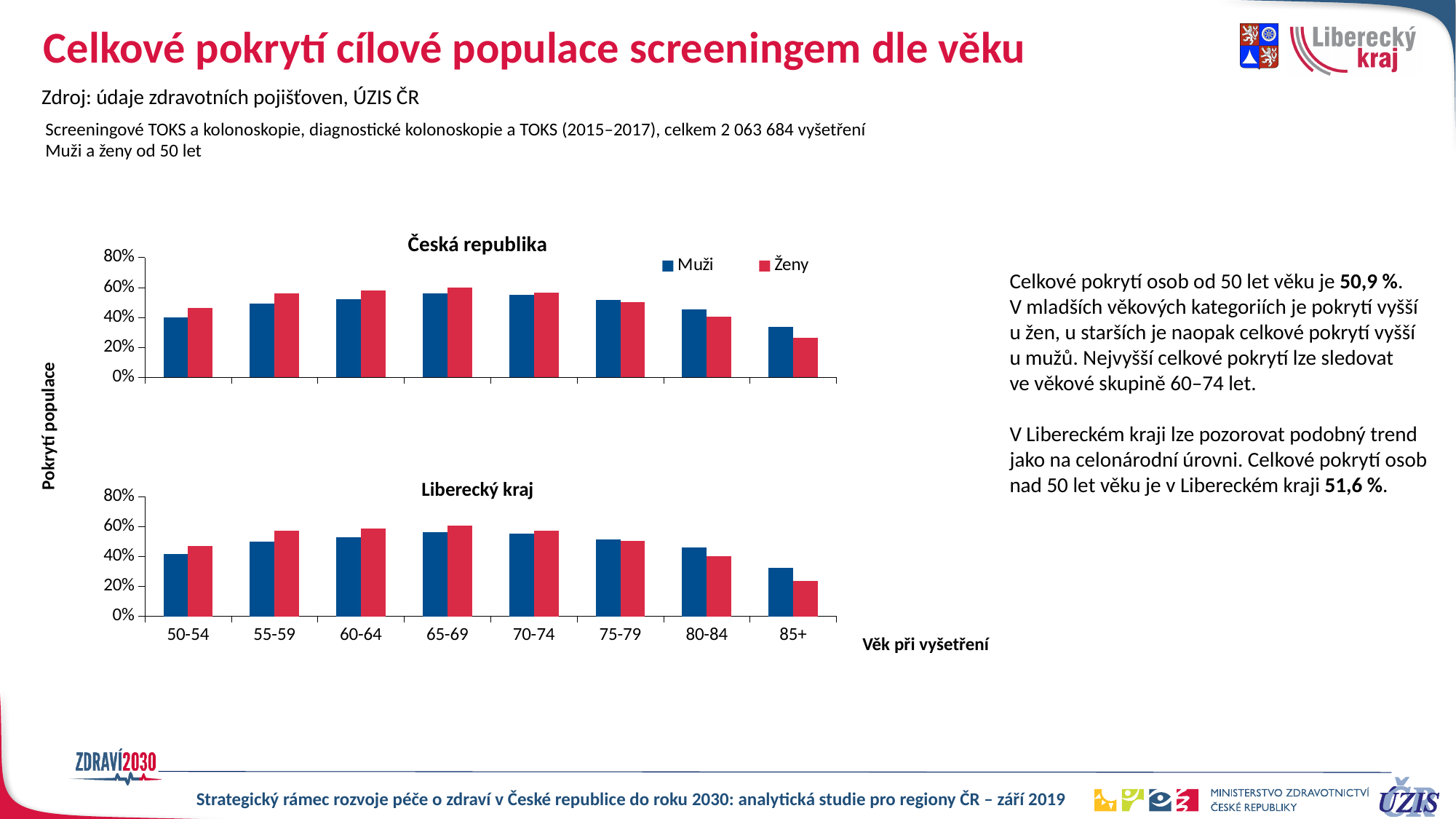
How many age categories are shown on the x axis of the 'Liberecký kraj' chart? 8 In the 'Liberecký kraj' chart, is the value for Muži in the 85+ group greater or less than 40%? less In the 'Česká republika' chart, is the value for Muži in the 65-69 group greater or less than 60%? less In the 'Liberecký kraj' chart, which age group has the lowest value for Ženy? 85+ In the 'Liberecký kraj' chart, which is larger for the 50-54 group, Muži or Ženy? Ženy How many series does the legend of the 'Česká republika' chart list? 2 In the 'Česká republika' chart, which age group has the highest value for Ženy? 65-69 What is the label of the y axis shared by the two charts? Pokrytí populace In the 'Česká republika' chart, is the value for Ženy in the 85+ group greater or less than 20%? greater What kind of chart is the 'Česká republika' chart? bar chart In the 'Liberecký kraj' chart, do the values for Ženy rise or fall from the 70-74 group to the 85+ group? fall In the 'Česká republika' chart, which is larger for the 85+ group, Muži or Ženy? Muži